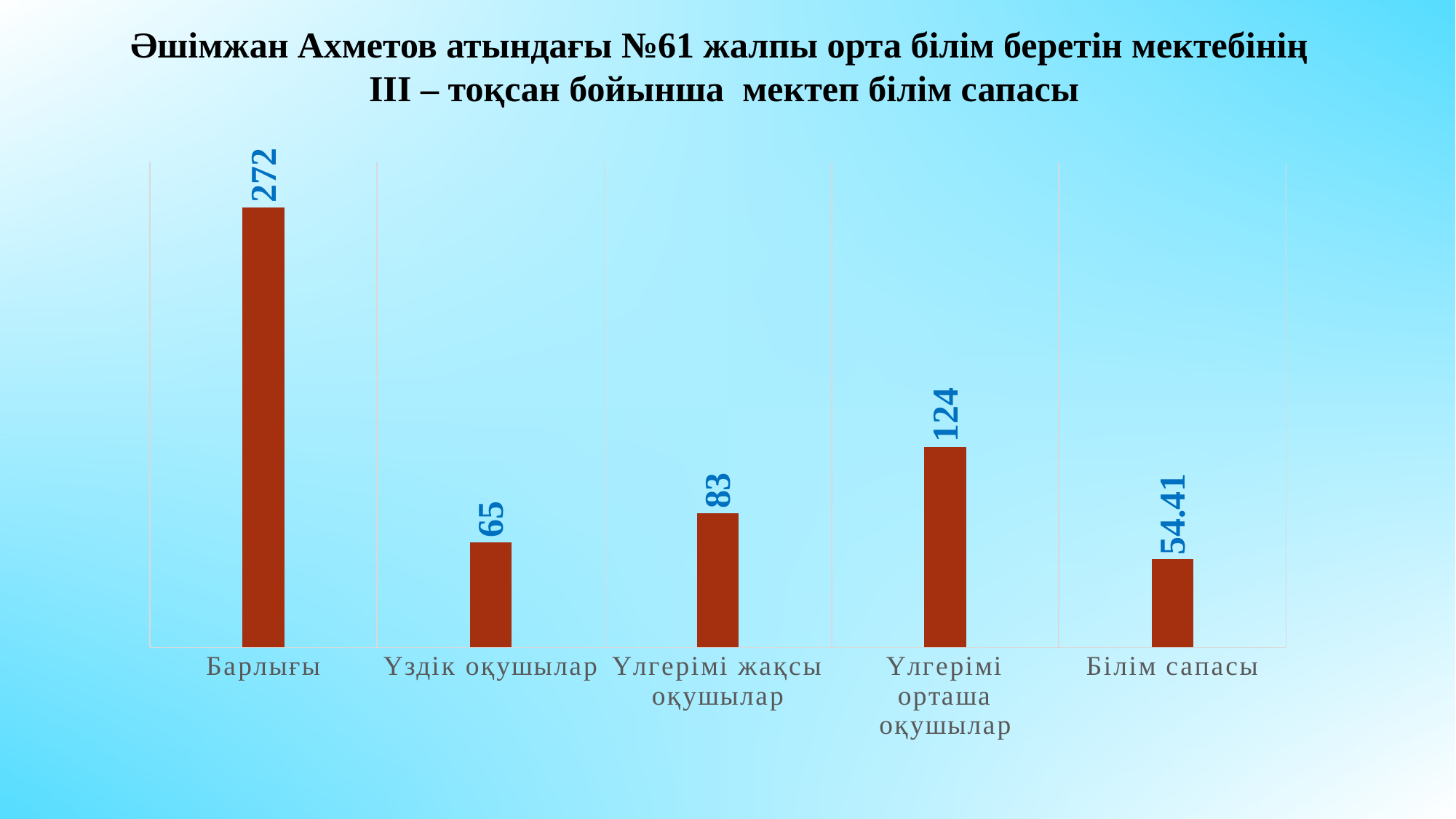
What is the value for Барлығы? 272 What is the value for Үлгерімі орташа оқушылар? 124 What is the value for Үздік оқушылар? 65 Which category has the highest value? Барлығы Which category has the lowest value? Білім сапасы What is the value for Білім сапасы? 54.41 Which is larger, the value for Үлгерімі орташа оқушылар or the value for Үлгерімі жақсы оқушылар? Үлгерімі орташа оқушылар How many categories are shown in the chart? 5 What is the difference between the values for Барлығы and Үлгерімі орташа оқушылар? 148 What is the value for Үлгерімі жақсы оқушылар? 83 What kind of chart is shown on the slide? bar chart What is the difference between the values for Үлгерімі жақсы оқушылар and Үздік оқушылар? 18